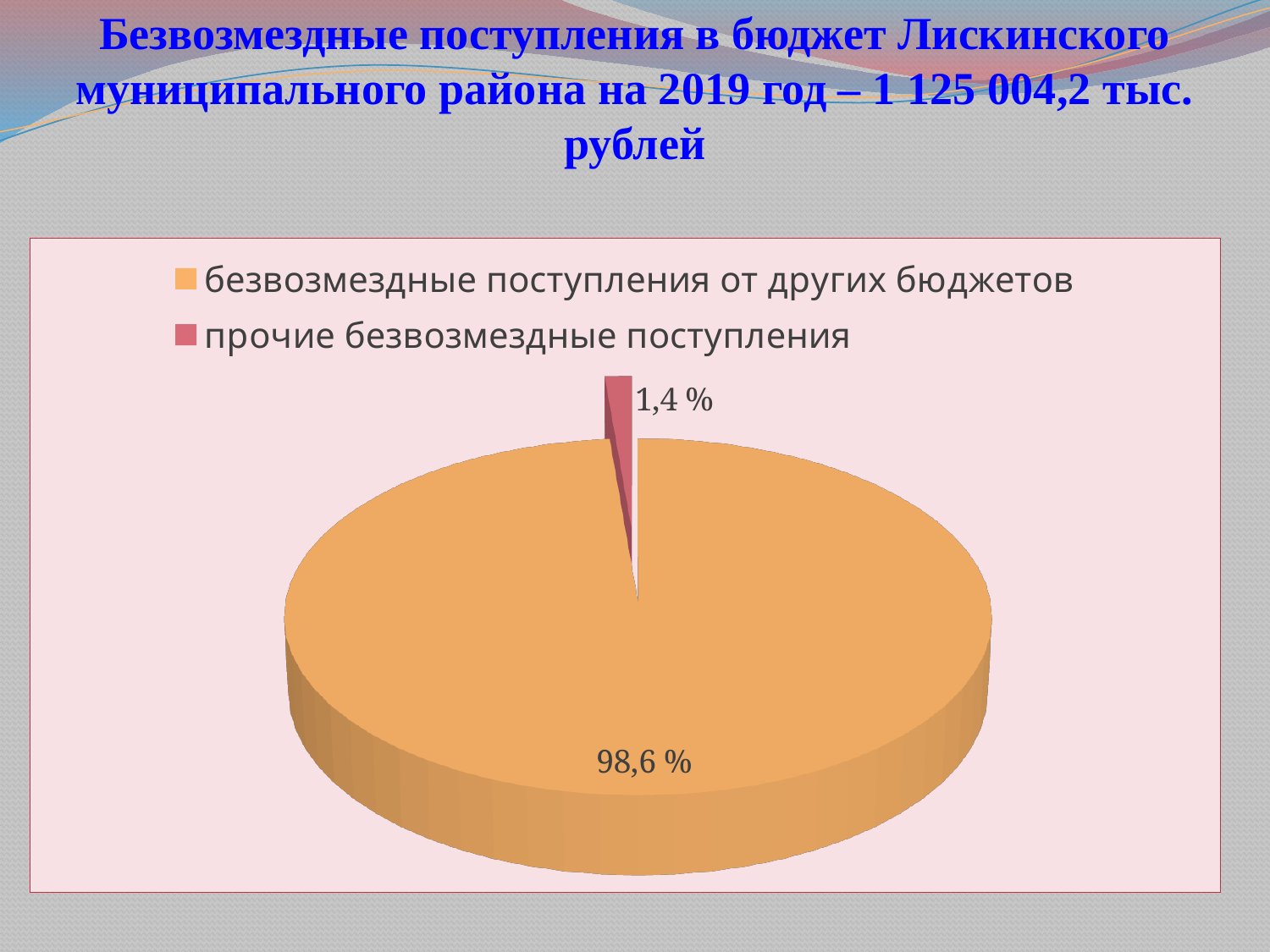
Which category has the largest slice of the pie? безвозмездные поступления от других бюджетов How many slices does the pie chart have? 2 What kind of chart is shown on the slide? pie chart What share of the pie does 'безвозмездные поступления от других бюджетов' represent? 98,6 % Which is larger: the share for 'безвозмездные поступления от других бюджетов' or for 'прочие безвозмездные поступления'? безвозмездные поступления от других бюджетов How many entries does the legend list? 2 What colour is the slice for 'прочие безвозмездные поступления'? red What share of the pie does 'прочие безвозмездные поступления' represent? 1,4 % What total amount of gratuitous receipts for 2019 is stated in the slide title? 1 125 004,2 тыс. рублей Which category has the smallest slice of the pie? прочие безвозмездные поступления What is the difference in percentage points between the two slices of the pie? 97,2